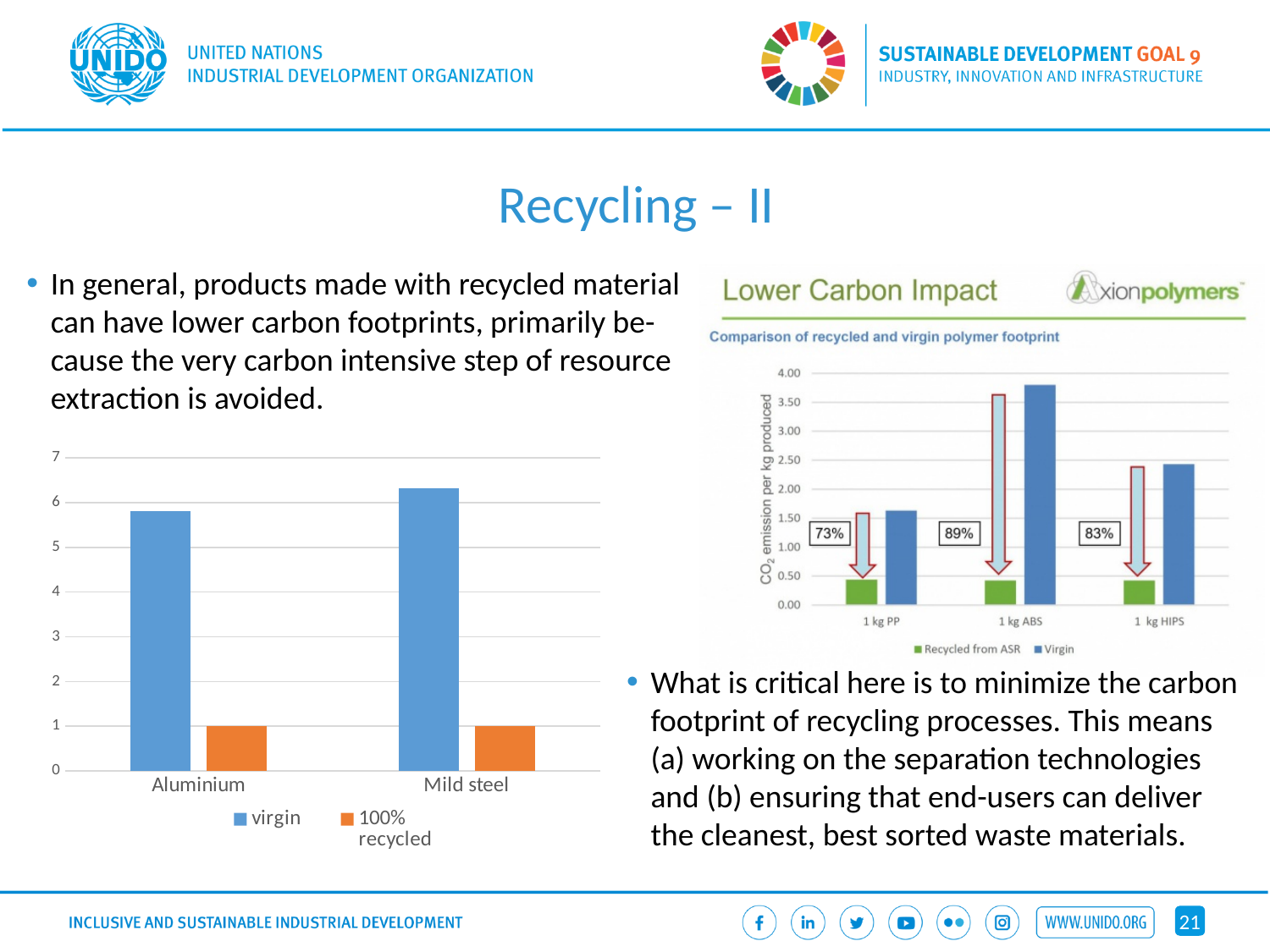
In the left chart, how many series does the legend list? 2 In the left chart, which category has the higher virgin value, Aluminium or Mild steel? Mild steel In the left chart, is the virgin value for Aluminium greater or less than 5? greater In the left chart, what kind of chart is shown? bar chart In the left chart, how many categories are shown on the x axis? 2 In the 'Lower Carbon Impact' chart, is the Virgin value for 1 kg ABS greater or less than 3.50? greater In the 'Lower Carbon Impact' chart, what percentage reduction is labelled for 1 kg PP? 73% In the left chart, is the virgin value for Mild steel greater or less than 6? greater In the 'Lower Carbon Impact' chart, what are the two series listed in the legend? Recycled from ASR and Virgin In the left chart, which series has the lower values for both categories? 100% recycled In the 'Lower Carbon Impact' chart, which material has the highest Virgin CO2 emission per kg produced? 1 kg ABS